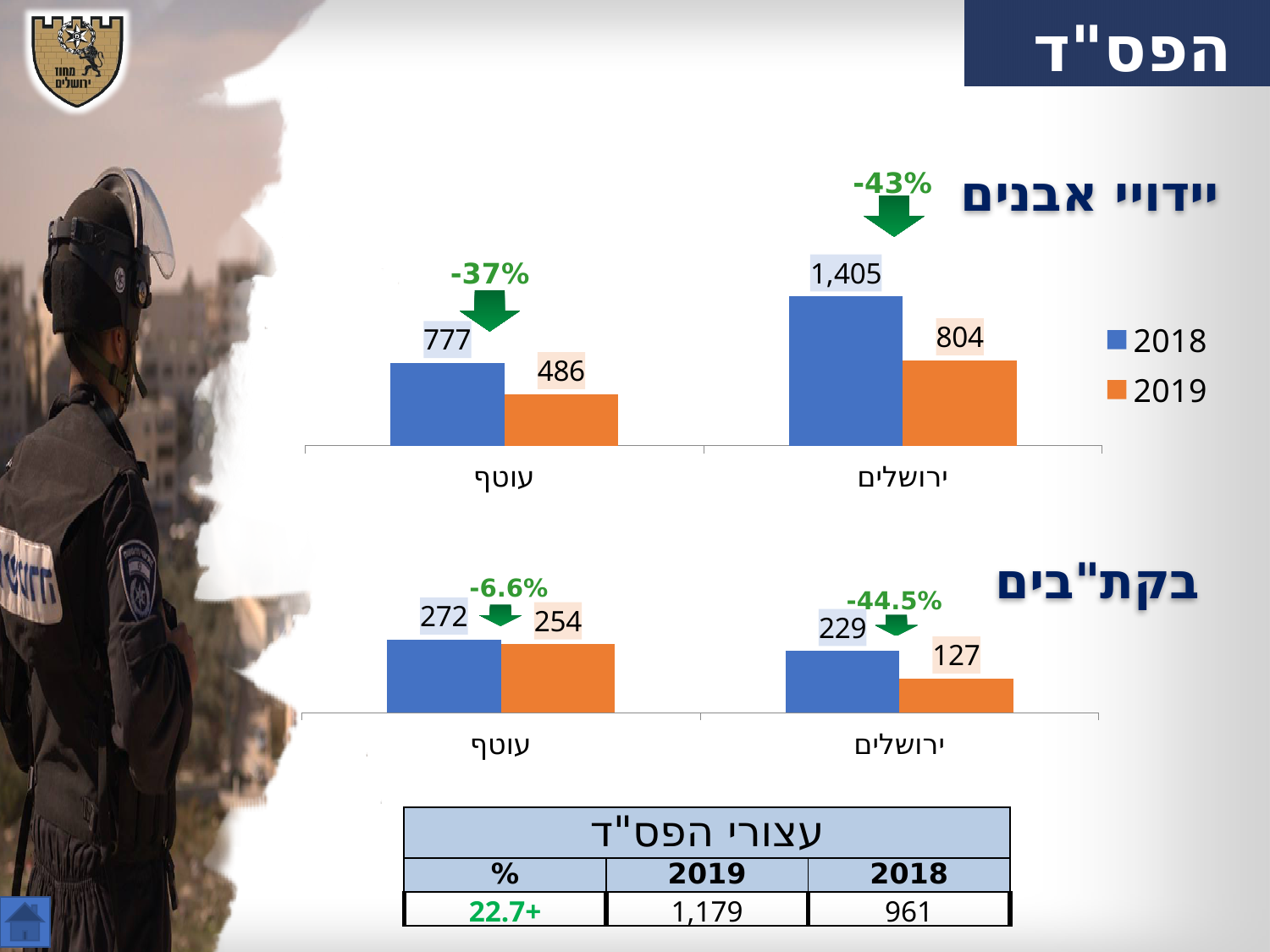
In the bottom chart (בקת"בים), what is the value for עוטף in 2018? 272 In the top chart (יידויי אבנים), what is the value for עוטף in 2019? 486 In the top chart (יידויי אבנים), what is the difference between the 2018 and 2019 values for ירושלים? 601 What kind of chart is the bottom chart (בקת"בים)? bar chart In the top chart (יידויי אבנים), how many categories are shown on the x axis? 2 In the top chart (יידויי אבנים), what is the value for ירושלים in 2018? 1,405 In the bottom chart (בקת"בים), which is larger: the 2019 value for עוטף or the 2019 value for ירושלים? עוטף In the top chart (יידויי אבנים), which category has the highest 2018 value? ירושלים In the bottom chart (בקת"בים), what is the difference between the 2018 and 2019 values for עוטף? 18 How many series does the legend list for the top chart (יידויי אבנים)? 2 In the top chart (יידויי אבנים), what percentage change is shown above the ירושלים bars? -43% In the bottom chart (בקת"בים), what is the value for ירושלים in 2019? 127